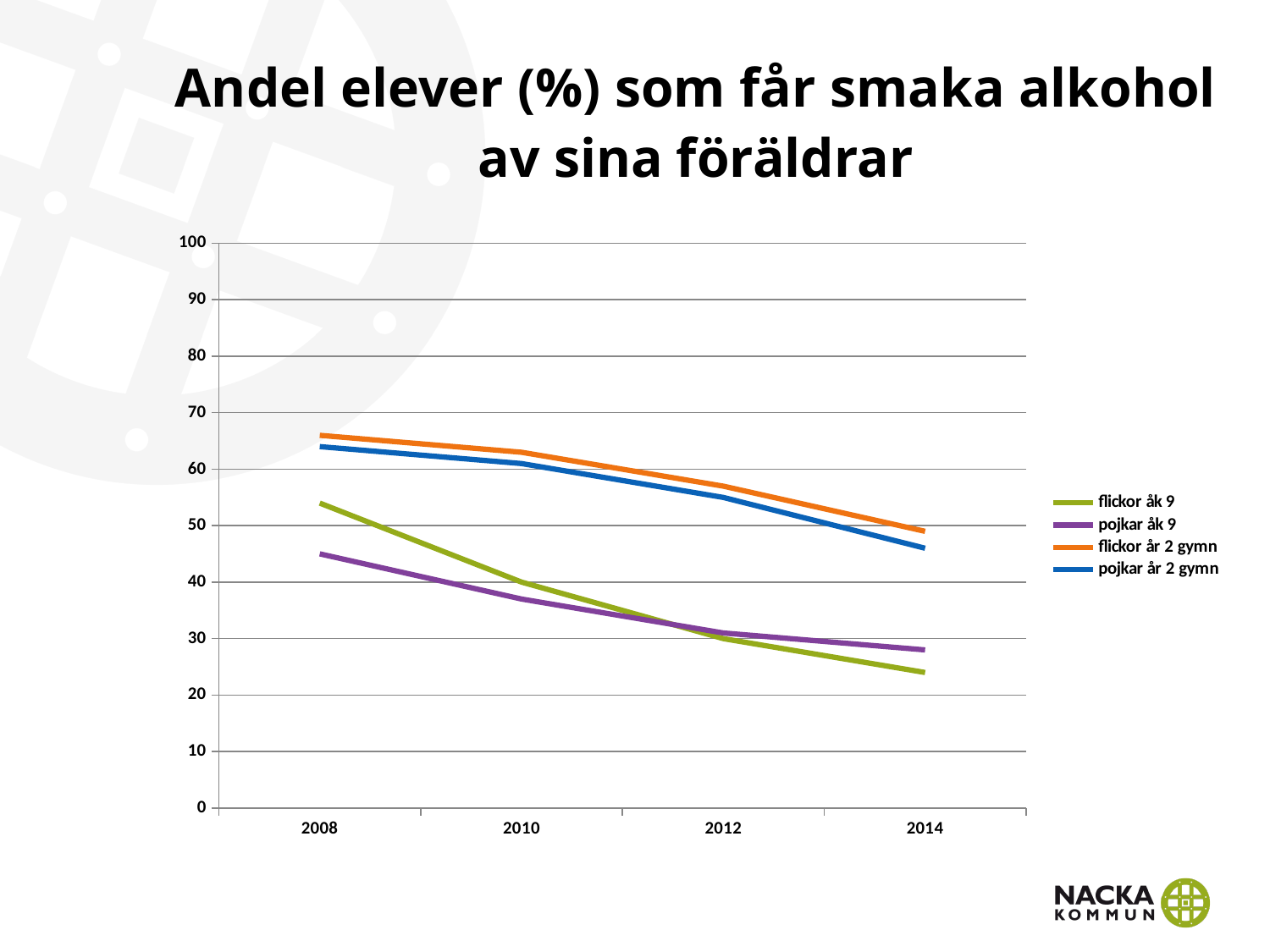
Which series has the highest value in 2014? flickor år 2 gymn Which series has the lowest value in 2014? flickor åk 9 Is the value for flickor åk 9 in 2008 greater or less than 50? greater Does the value for flickor år 2 gymn rise or fall from 2008 to 2014? fall What is the title of the chart? Andel elever (%) som får smaka alkohol av sina föräldrar Is the value for pojkar år 2 gymn in 2014 greater or less than 50? less How many series does the legend list? 4 Is the value for flickor åk 9 in 2014 greater or less than 30? less What kind of chart is shown on the slide? line chart In 2008, which is higher: flickor åk 9 or pojkar åk 9? flickor åk 9 How many years are shown on the x axis? 4